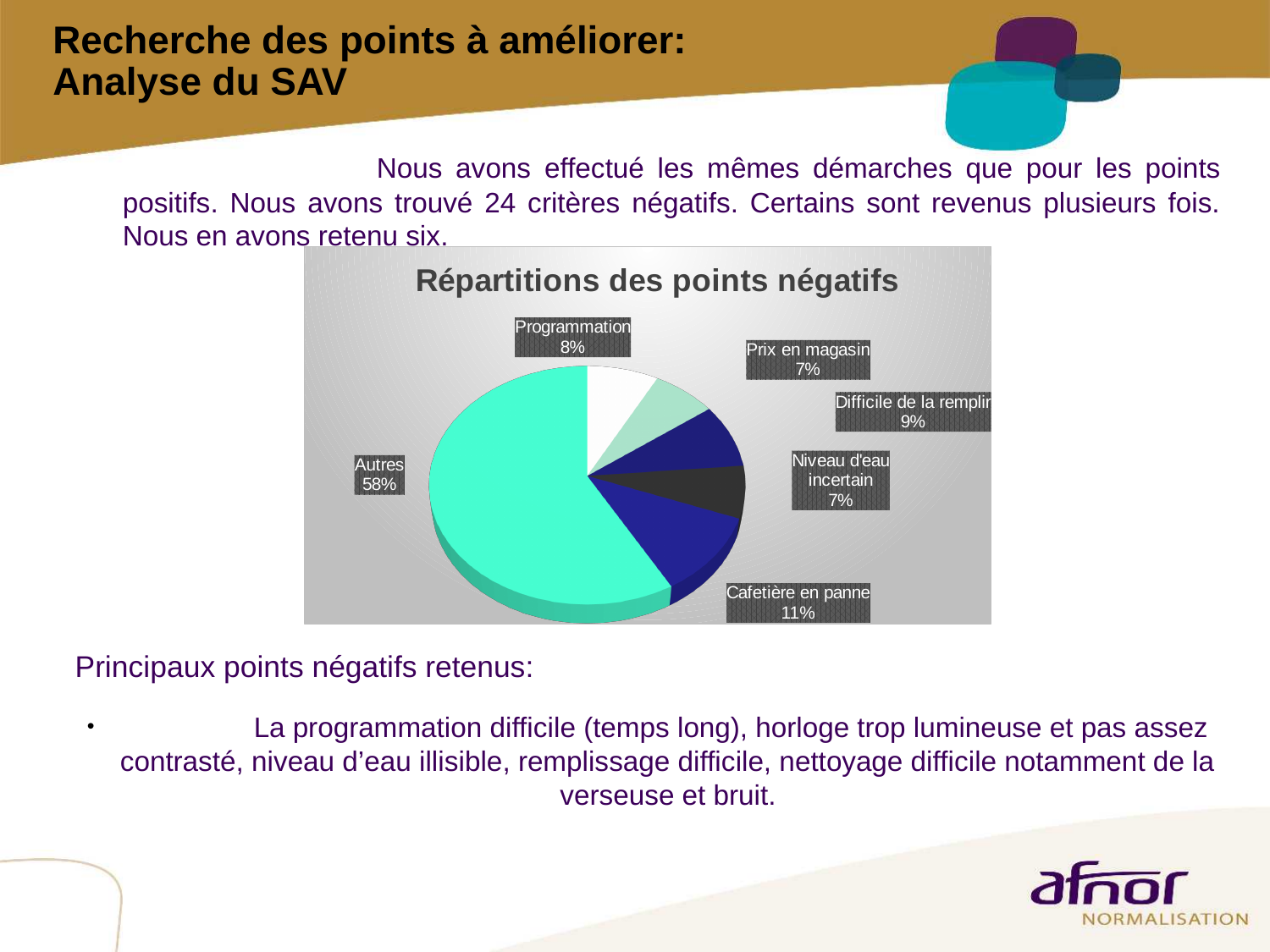
What is the title of the chart? Répartitions des points négatifs How many slices does the pie chart have? 6 What is the difference between the values for "Cafetière en panne" and "Programmation"? 3% What share of the pie does "Autres" represent? 58% What is the difference between the values for "Autres" and "Cafetière en panne"? 47% What is the value shown for "Cafetière en panne"? 11% What kind of chart is shown on the slide? pie chart What is the value shown for "Programmation"? 8% Which is larger, the value for "Difficile de la remplir" or the value for "Niveau d'eau incertain"? Difficile de la remplir Which slice of the pie is the largest? Autres What is the value shown for "Prix en magasin"? 7% What is the value shown for "Difficile de la remplir"? 9%